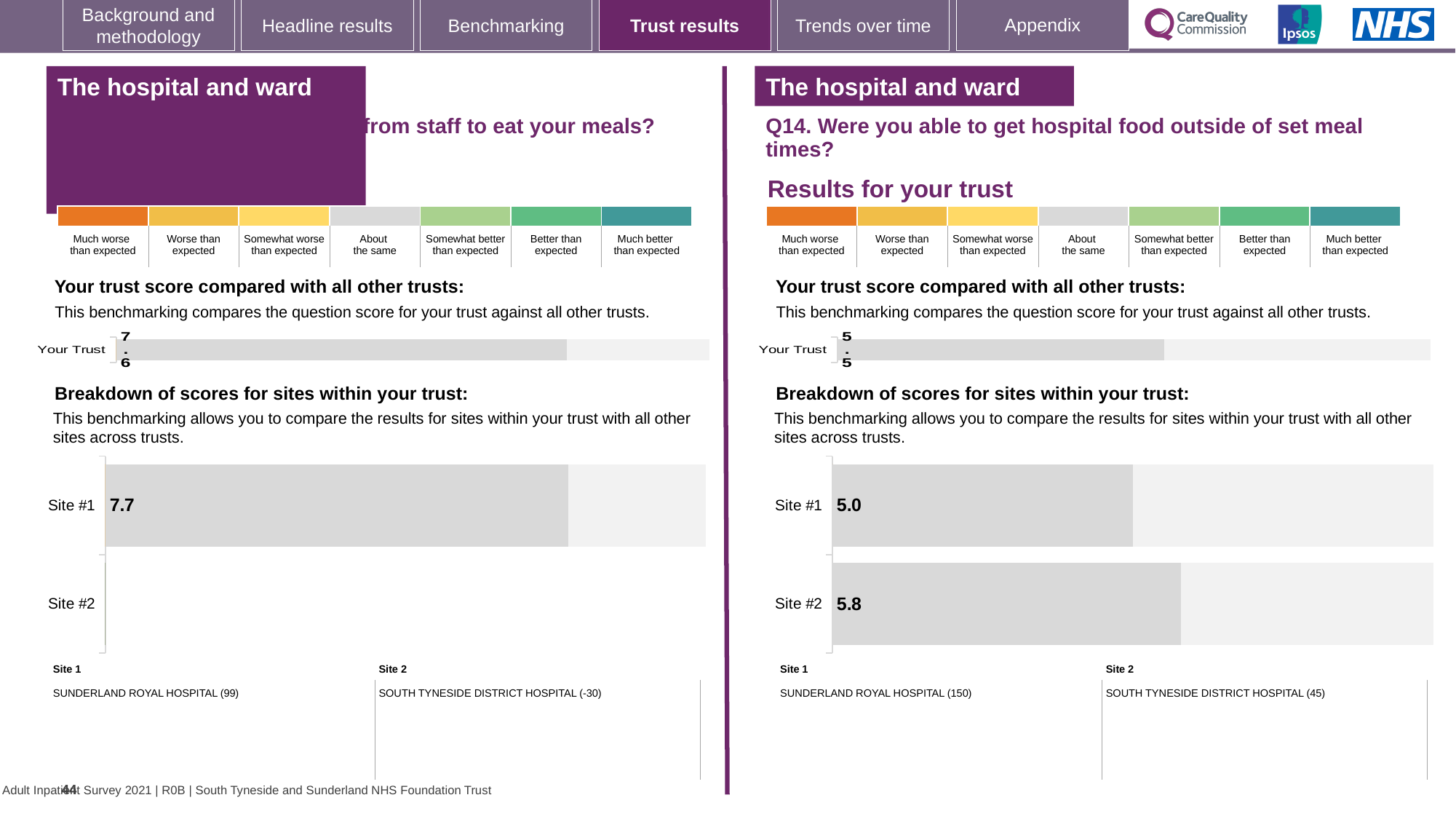
On the right-hand Q14 'Your trust score compared with all other trusts' chart, what is the score for Your Trust? 5.5 What kind of chart is the right-hand Q14 site breakdown chart? Bar chart On the right-hand Q14 site breakdown chart, which site has the lowest score? Site #1 On the right-hand chart for Q14 (Breakdown of scores for sites within your trust), what is the score for Site #2? 5.8 On the left-hand site breakdown chart, which hospital is Site 2? SOUTH TYNESIDE DISTRICT HOSPITAL (-30) On the right-hand Q14 site breakdown chart, which hospital is Site 1? SUNDERLAND ROYAL HOSPITAL (150) On the left-hand chart (Breakdown of scores for sites within your trust), what is the score for Site #1? 7.7 On the right-hand Q14 site breakdown chart, what is the difference between the scores for Site #2 and Site #1? 0.8 On the left-hand 'Your trust score compared with all other trusts' chart, what is the score for Your Trust? 7.6 How many sites are listed on the right-hand Q14 site breakdown chart? 2 On the right-hand Q14 site breakdown chart, which site has the higher score, Site #1 or Site #2? Site #2 On the right-hand chart for Q14 (Breakdown of scores for sites within your trust), what is the score for Site #1? 5.0